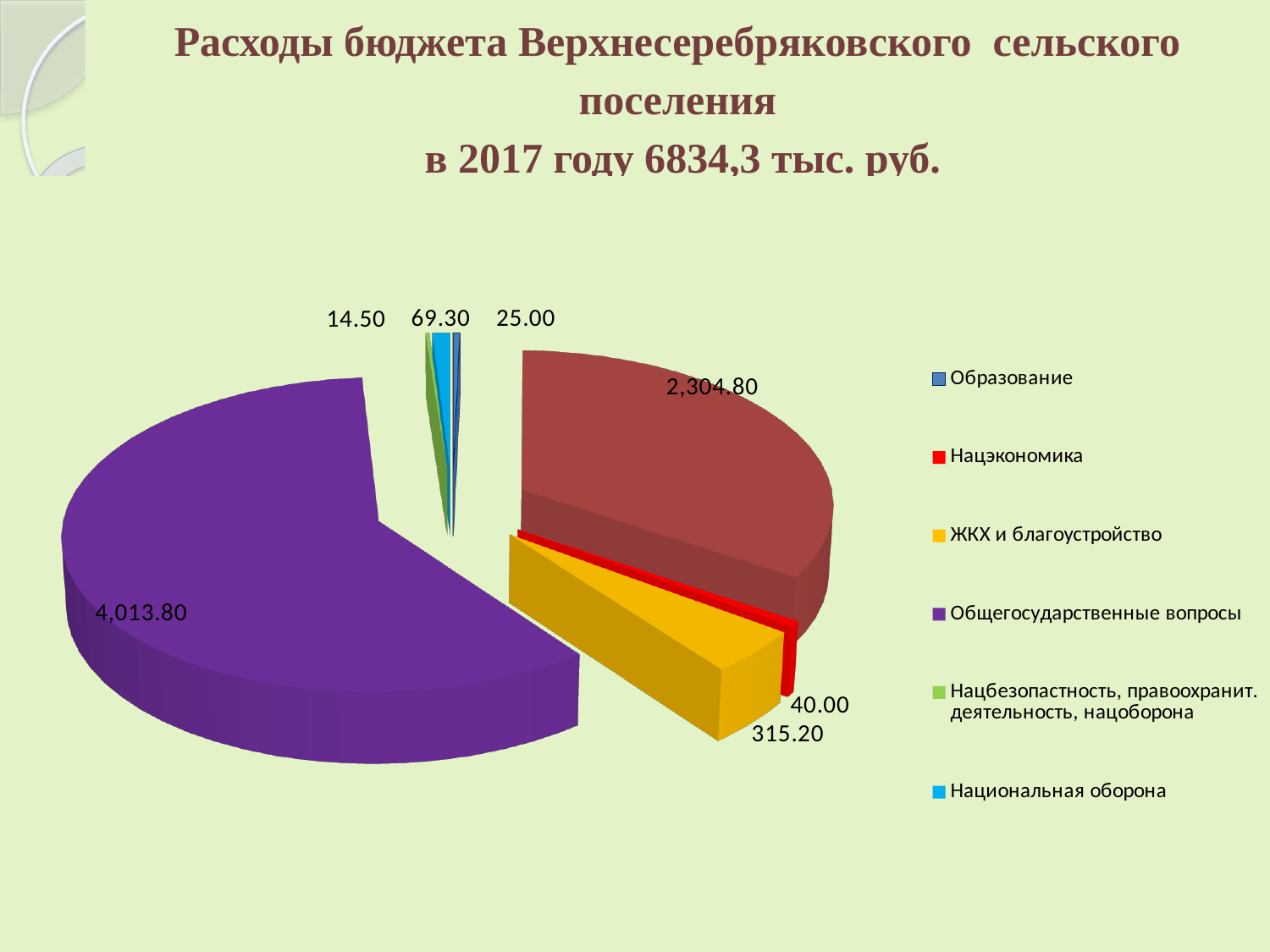
What is the value for ЖКХ и благоустройство? 315.20 What is the value for Нацэкономика? 40.00 Which is larger: the value for ЖКХ и благоустройство or the value for Нацэкономика? ЖКХ и благоустройство Which category has the largest slice in the pie chart? Общегосударственные вопросы What kind of chart is shown on the slide? pie chart What is the value for Национальная оборона? 69.30 What is the value for Общегосударственные вопросы? 4,013.80 How many entries does the legend list? 6 What is the value of the smallest slice in the pie chart? 14.50 What total budget expenditure for 2017 is stated in the chart title? 6834,3 тыс. руб. What is the value of the largest slice in the pie chart? 4,013.80 What is the difference between the slice labelled 4,013.80 and the slice labelled 2,304.80? 1,709.00